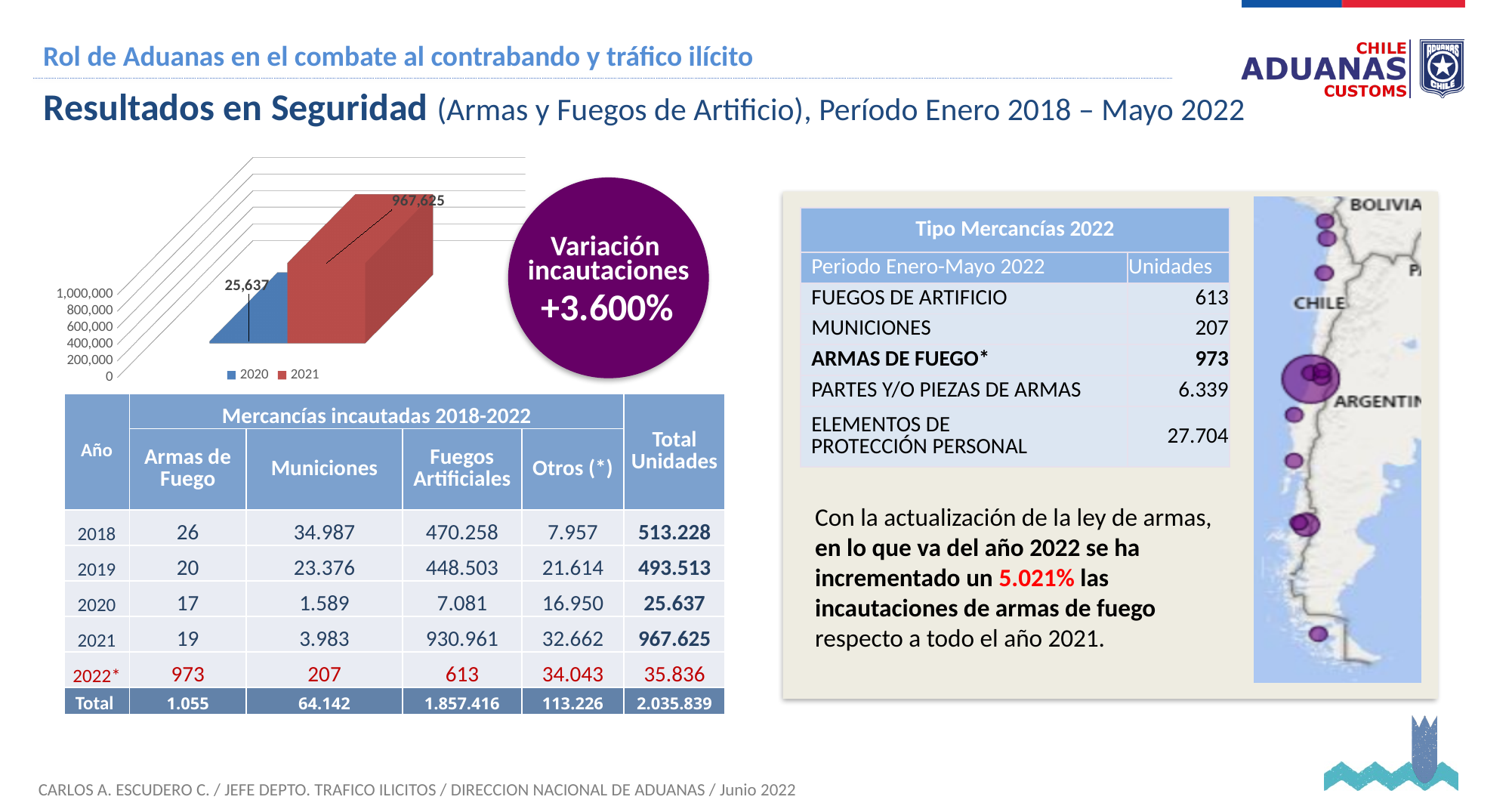
What value is shown for the 2021 bar in the chart? 967,625 What is the highest tick value shown on the chart's vertical axis? 1,000,000 Which series in the chart has the lower value? 2020 Is the value for 2021 in the chart greater or less than 800,000? greater What kind of chart is shown on the slide? bar chart Which series in the chart has the higher value, 2020 or 2021? 2021 Is the value for 2020 in the chart greater or less than 200,000? less What is the difference between the 2021 value and the 2020 value in the chart? 941,988 How many series does the chart legend list? 2 How many bars are plotted in the chart? 2 What value is shown for the 2020 bar in the chart? 25,637 What colour is the 2021 series in the chart? red